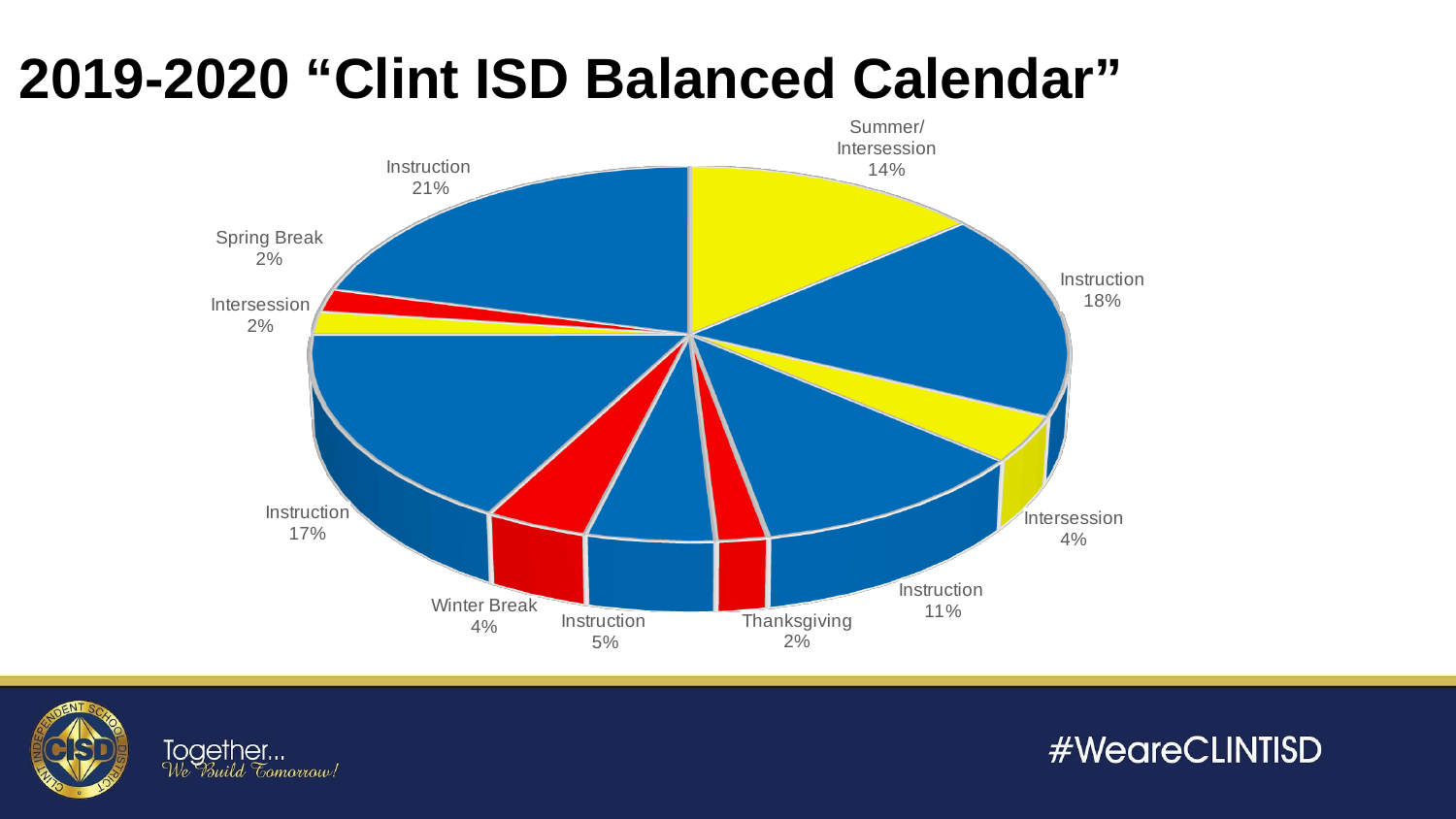
Which slice is larger, Winter Break or Thanksgiving? Winter Break What colour are the Winter Break and Thanksgiving slices? Red What kind of chart is shown on the slide? Pie chart What percentage is shown for the Thanksgiving slice? 2% By how many percentage points is the Summer/Intersession slice larger than the Winter Break slice? 10 percentage points What percentage is shown for the Summer/Intersession slice? 14% What is the largest percentage shown on any slice of the pie chart? 21% What is the smallest percentage shown on any slice of the pie chart? 2% How many slices does the pie chart have? 11 What percentage is shown for the Spring Break slice? 2% What percentage is shown for the Winter Break slice? 4% What is the title of the slide containing the chart? 2019-2020 "Clint ISD Balanced Calendar"